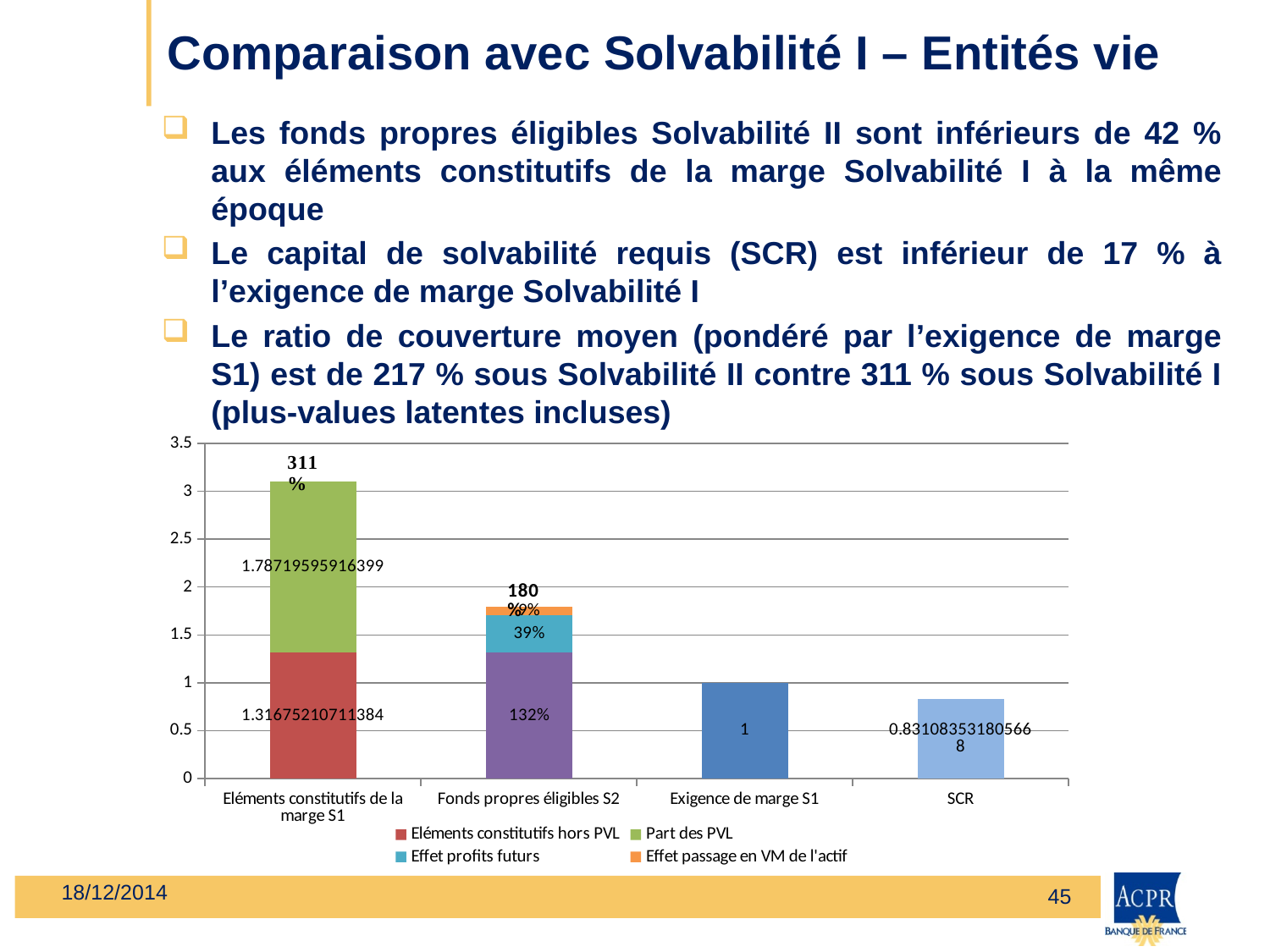
How many categories are shown on the x axis of the chart? 4 What total label is printed above the Eléments constitutifs de la marge S1 bar? 311 % What is the value of the Part des PVL segment in the Eléments constitutifs de la marge S1 bar? 1.78719595916399 What total label is printed above the Fonds propres éligibles S2 bar? 180 % What kind of chart is shown on the slide? Stacked bar chart Which category has the tallest bar in the chart? Eléments constitutifs de la marge S1 Is the value for SCR greater or less than 1? less What is the value of the Eléments constitutifs hors PVL segment in the Eléments constitutifs de la marge S1 bar? 1.31675210711384 Which category has the shortest bar in the chart? SCR How many series does the chart legend list? 4 What is the value of the bar for Exigence de marge S1? 1 What is the value of the Effet profits futurs segment in the Fonds propres éligibles S2 bar? 39%